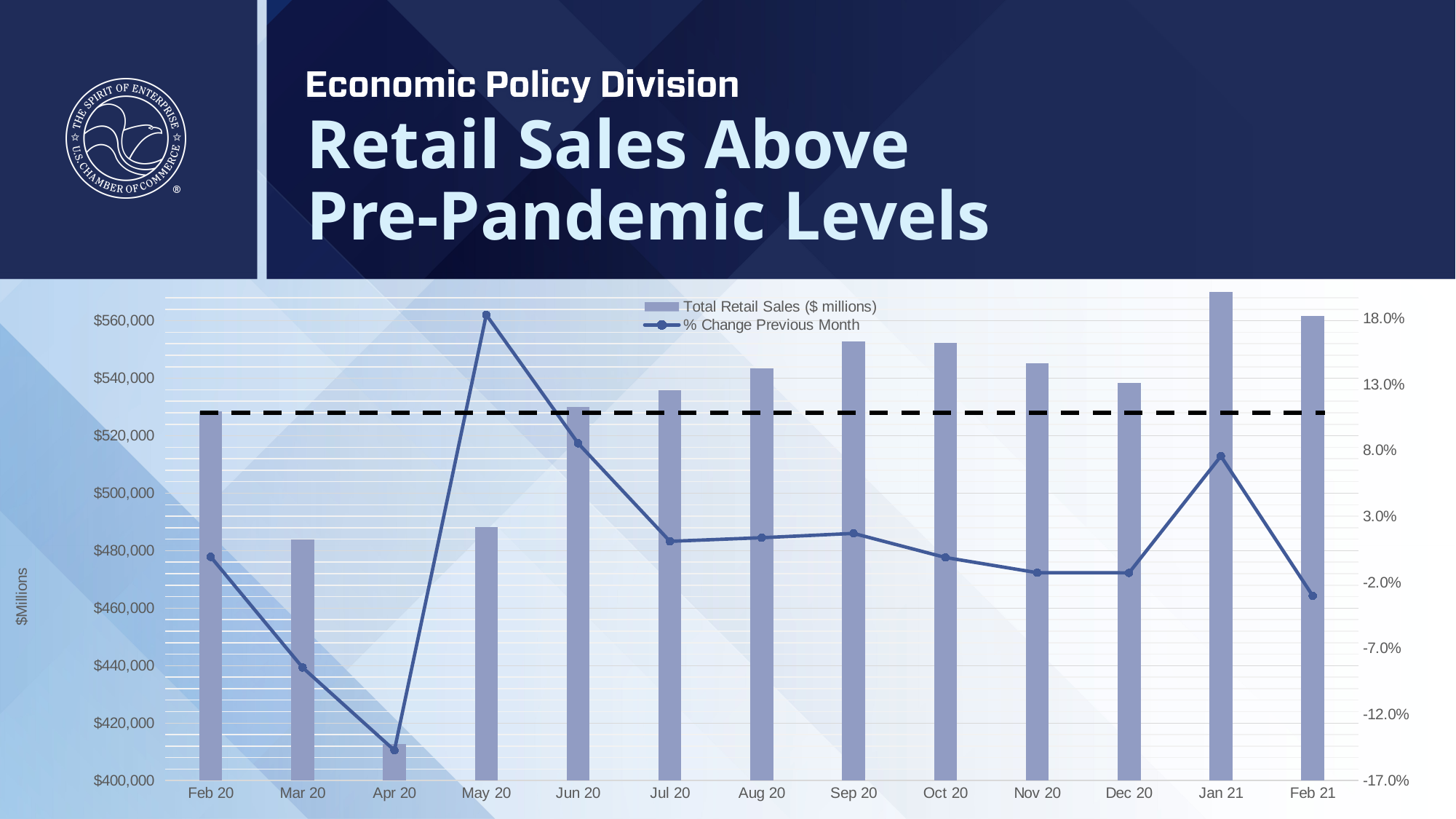
Is the Total Retail Sales value for Apr 20 greater or less than $420,000? less How many series does the chart legend list? 2 How many months are plotted along the x axis? 13 Which month has the highest % Change Previous Month value? May 20 Do the Total Retail Sales bars rise or fall from Apr 20 to Sep 20? Rise Which month has the lowest Total Retail Sales bar? Apr 20 What is the label of the series plotted as bars in the legend? Total Retail Sales ($ millions) What type of chart is shown on the slide? A combination bar and line chart Is the % Change Previous Month value for May 20 greater or less than 13.0%? greater Is the Total Retail Sales value for Jan 21 greater or less than $560,000? greater Which month has the highest Total Retail Sales bar? Jan 21 Which month has the larger Total Retail Sales bar, Jan 21 or Feb 21? Jan 21